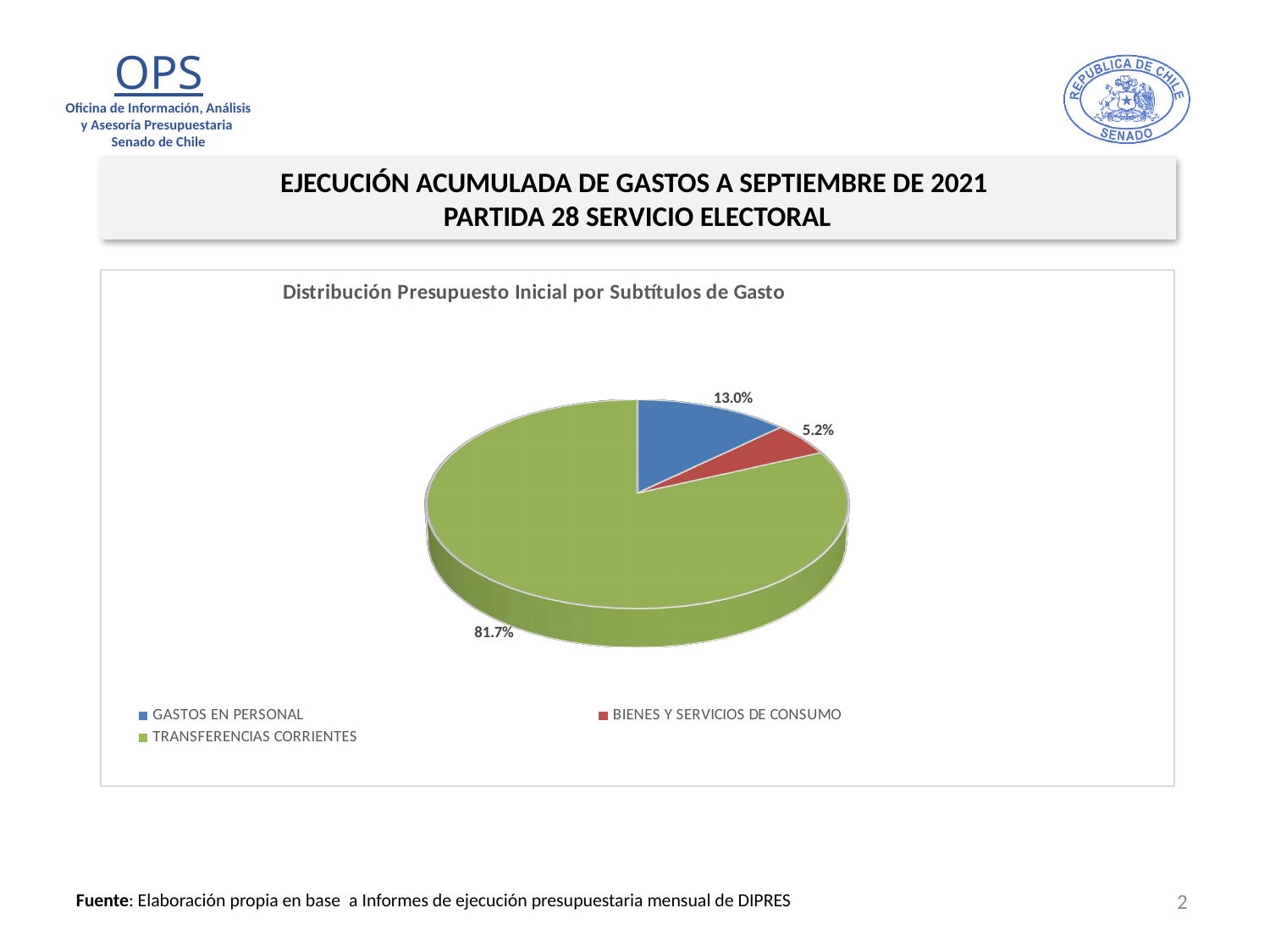
What share of the pie does GASTOS EN PERSONAL represent? 13.0% What is the title of the chart? Distribución Presupuesto Inicial por Subtítulos de Gasto Which category has the largest slice of the pie? TRANSFERENCIAS CORRIENTES What share of the pie does TRANSFERENCIAS CORRIENTES represent? 81.7% What is the difference in percentage points between GASTOS EN PERSONAL and BIENES Y SERVICIOS DE CONSUMO? 7.8 What colour is the slice for TRANSFERENCIAS CORRIENTES? Green What kind of chart is shown on the slide? Pie chart Which category has the smallest slice of the pie? BIENES Y SERVICIOS DE CONSUMO Which is larger, the share for GASTOS EN PERSONAL or the share for BIENES Y SERVICIOS DE CONSUMO? GASTOS EN PERSONAL What is the difference in percentage points between TRANSFERENCIAS CORRIENTES and GASTOS EN PERSONAL? 68.7 How many categories does the legend list? 3 What share of the pie does BIENES Y SERVICIOS DE CONSUMO represent? 5.2%